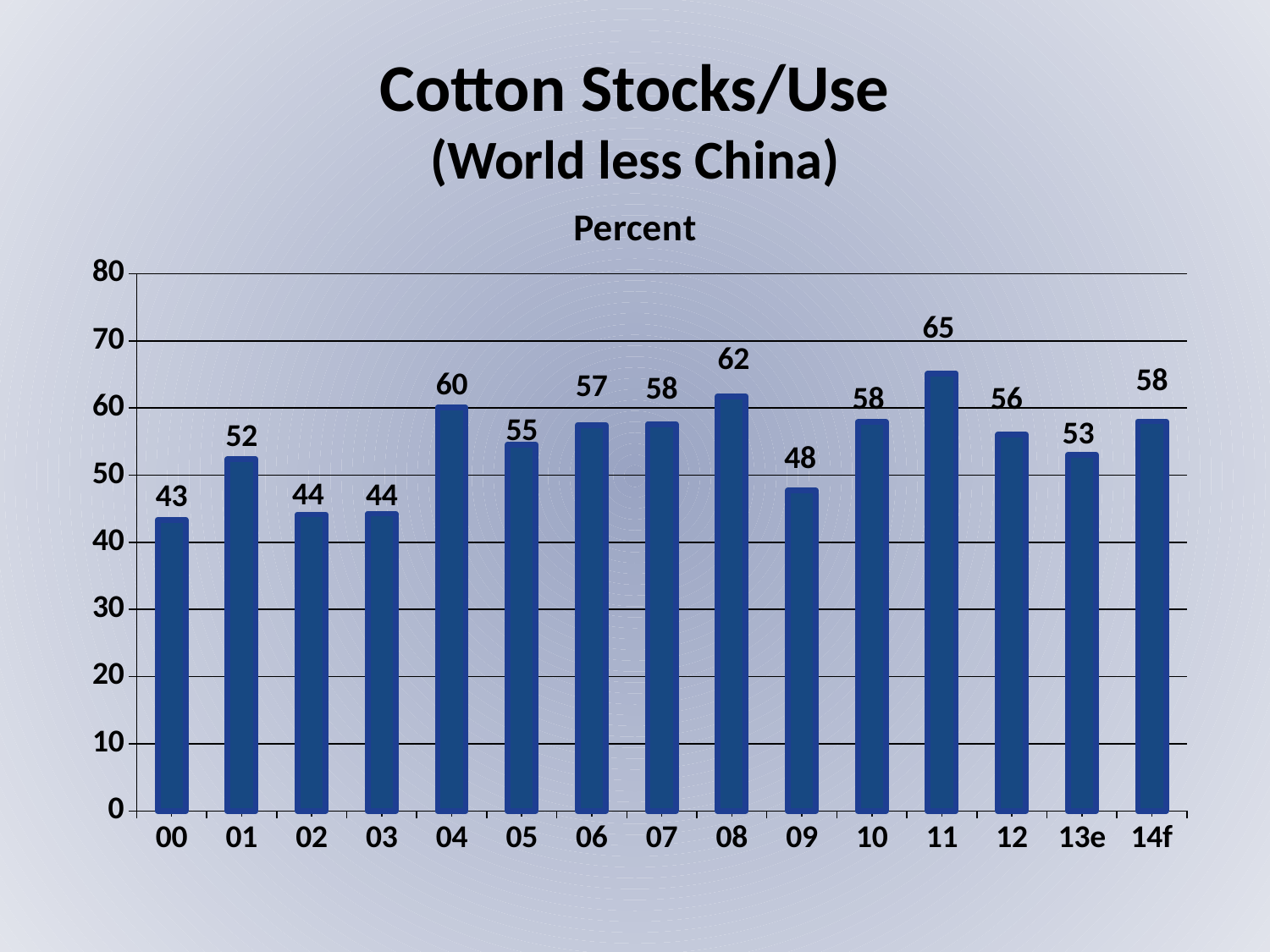
How many years are shown on the x axis? 15 What unit is indicated above the chart? Percent Do the values rise or fall from 00 to 04? rise What is the value shown for 13e? 53 Is the value for 08 greater or less than 60? greater What is the cotton stocks/use value for 11? 65 What is the difference between the values for 11 and 09? 17 What kind of chart is shown on the slide? bar chart Which year has the lowest stocks/use value? 00 Which is larger, the value for 04 or the value for 05? 04 Which year has the highest stocks/use value? 11 What is the value shown for 00? 43